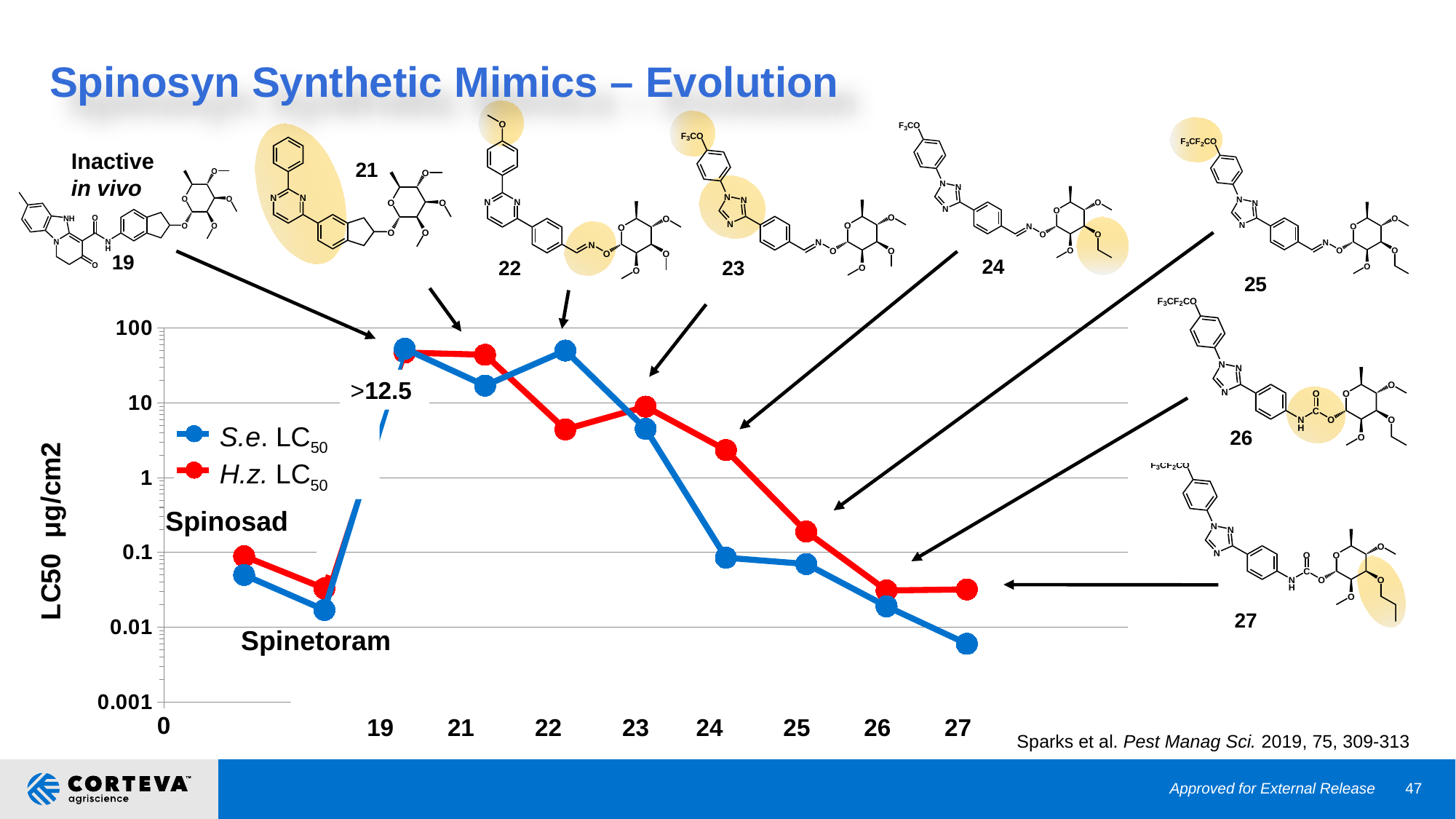
At compound 24, which series has the higher LC50 value, S.e. or H.z.? H.z. LC50 At compound 22, which series has the higher LC50 value, S.e. or H.z.? S.e. LC50 What are the two series named in the chart legend? S.e. LC50 and H.z. LC50 How many series does the chart legend list? 2 From compound 22 to compound 27, does the S.e. LC50 series rise or fall? fall Is the H.z. LC50 value for compound 25 greater or less than 0.1? greater What kind of chart is shown on the slide? line chart Which compound has the lowest S.e. LC50 value on the chart? 27 What is the label on the chart's y axis? LC50 µg/cm2 Is the H.z. LC50 value for compound 24 greater or less than 1? greater Is the S.e. LC50 value for compound 21 greater or less than 10? greater